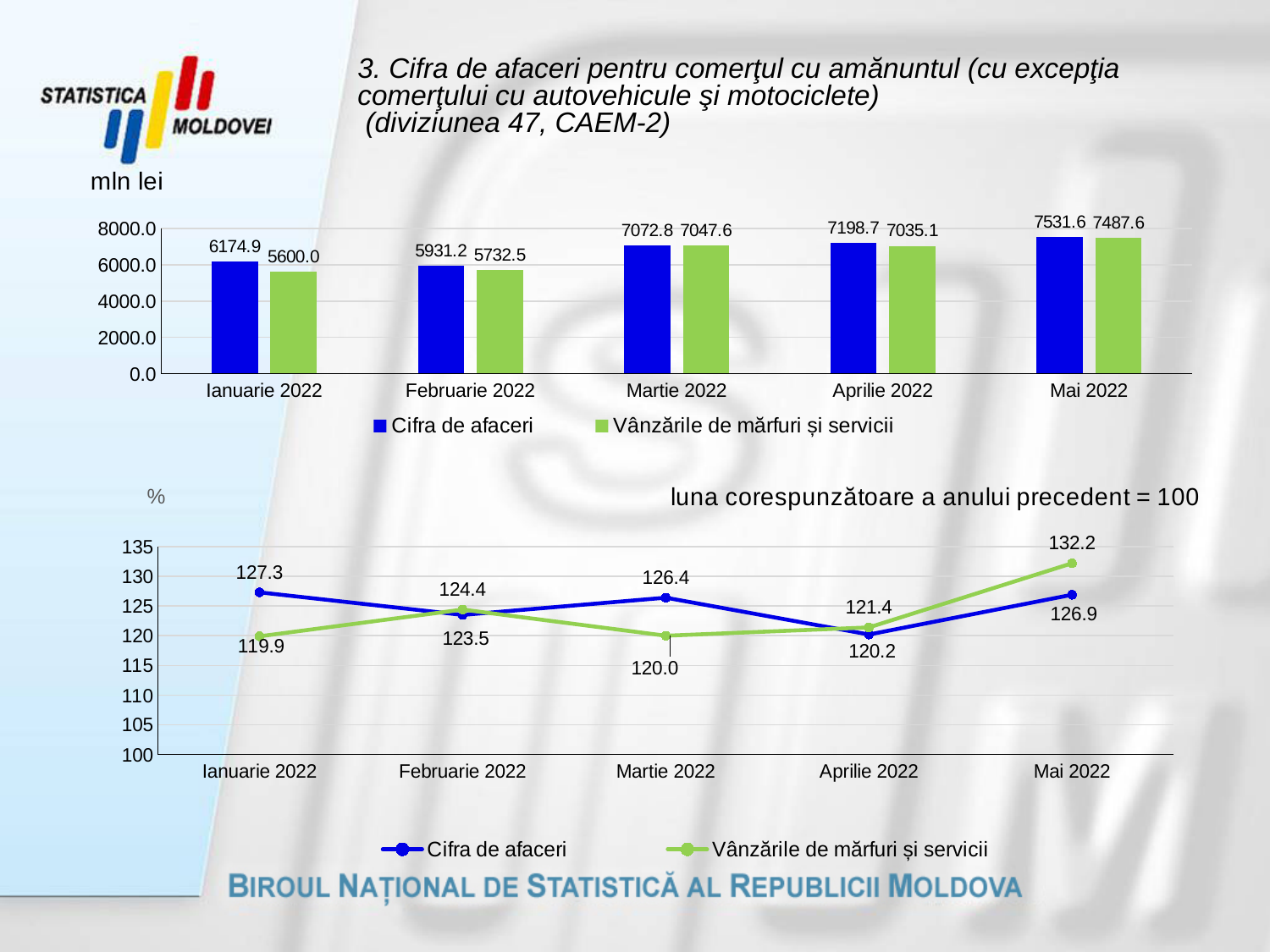
In the bottom line chart, what is the difference between Vânzările de mărfuri și servicii and Cifra de afaceri for Mai 2022? 5.3 In the bottom line chart, what is the value of Cifra de afaceri for Aprilie 2022? 120.2 What kind of chart is the top chart on the slide? bar chart In the top bar chart, what is the value of Vânzările de mărfuri și servicii for Ianuarie 2022? 5600.0 How many series does the legend of the bottom line chart list? 2 In the bottom line chart, which is larger for Februarie 2022: Cifra de afaceri or Vânzările de mărfuri și servicii? Vânzările de mărfuri și servicii In the top bar chart, what is the value of Cifra de afaceri for Martie 2022? 7072.8 In the top bar chart, what is the difference between Cifra de afaceri and Vânzările de mărfuri și servicii for Ianuarie 2022? 574.9 In the bottom line chart, what is the value of Vânzările de mărfuri și servicii for Mai 2022? 132.2 In the top bar chart, which month has the highest value for Cifra de afaceri? Mai 2022 In the top bar chart, how many months are shown on the x axis? 5 In the top bar chart, which month has the lowest value for Vânzările de mărfuri și servicii? Ianuarie 2022